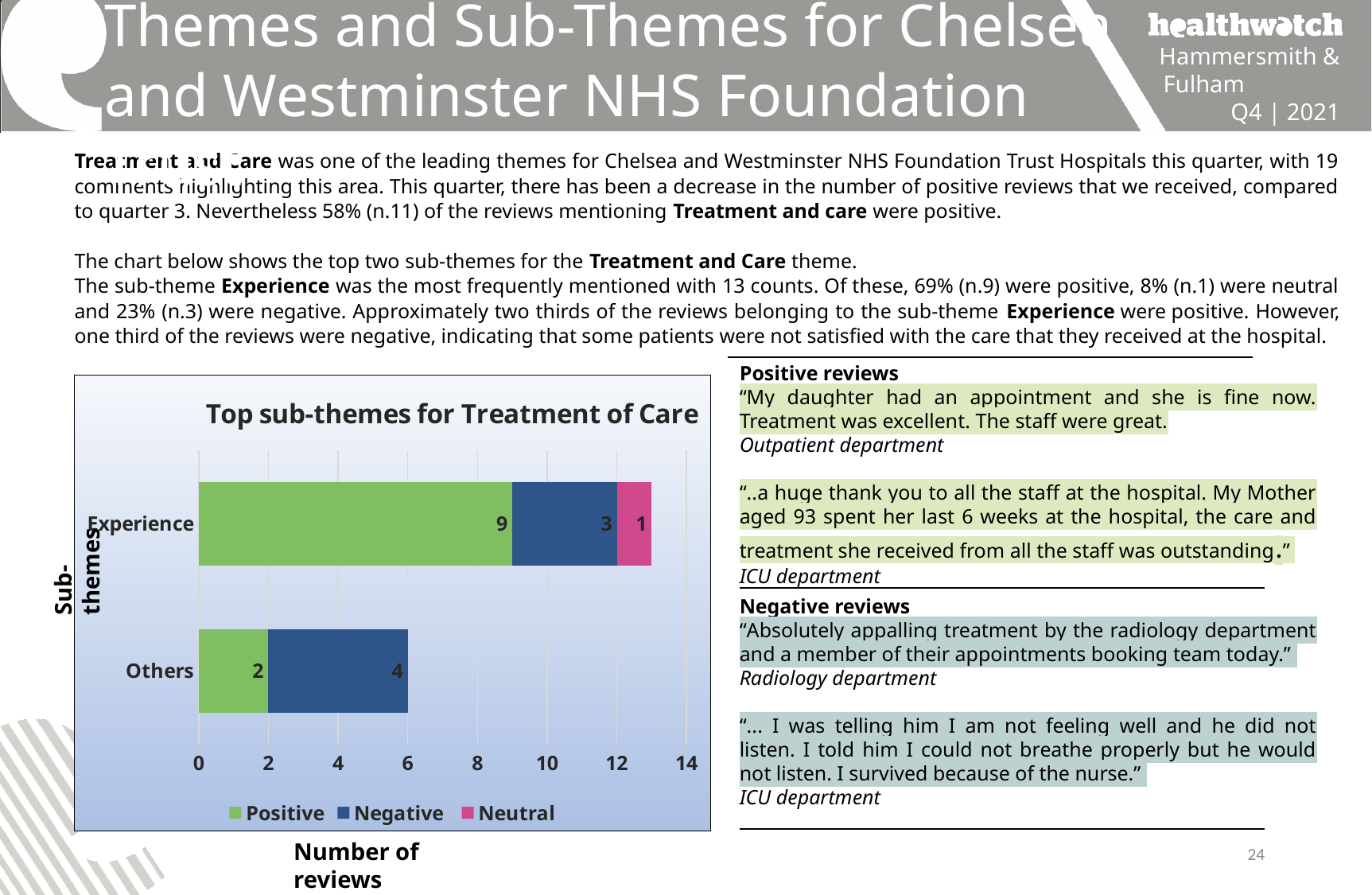
What is the Neutral value for Experience in the chart? 1 Which sub-theme has the highest total number of reviews? Experience What is the total number of reviews for the Experience bar? 13 How many sub-theme categories are shown in the chart? 2 What is the Positive value for Others in the chart? 2 Which sub-theme has the larger Negative value, Experience or Others? Others What is the Positive value for Experience in the chart? 9 What is the Negative value for Others in the chart? 4 What type of chart is shown on the slide? Stacked bar chart What is the total number of reviews for the Others bar? 6 What is the difference between the Positive value for Experience and the Positive value for Others? 7 How many series does the chart legend list? 3